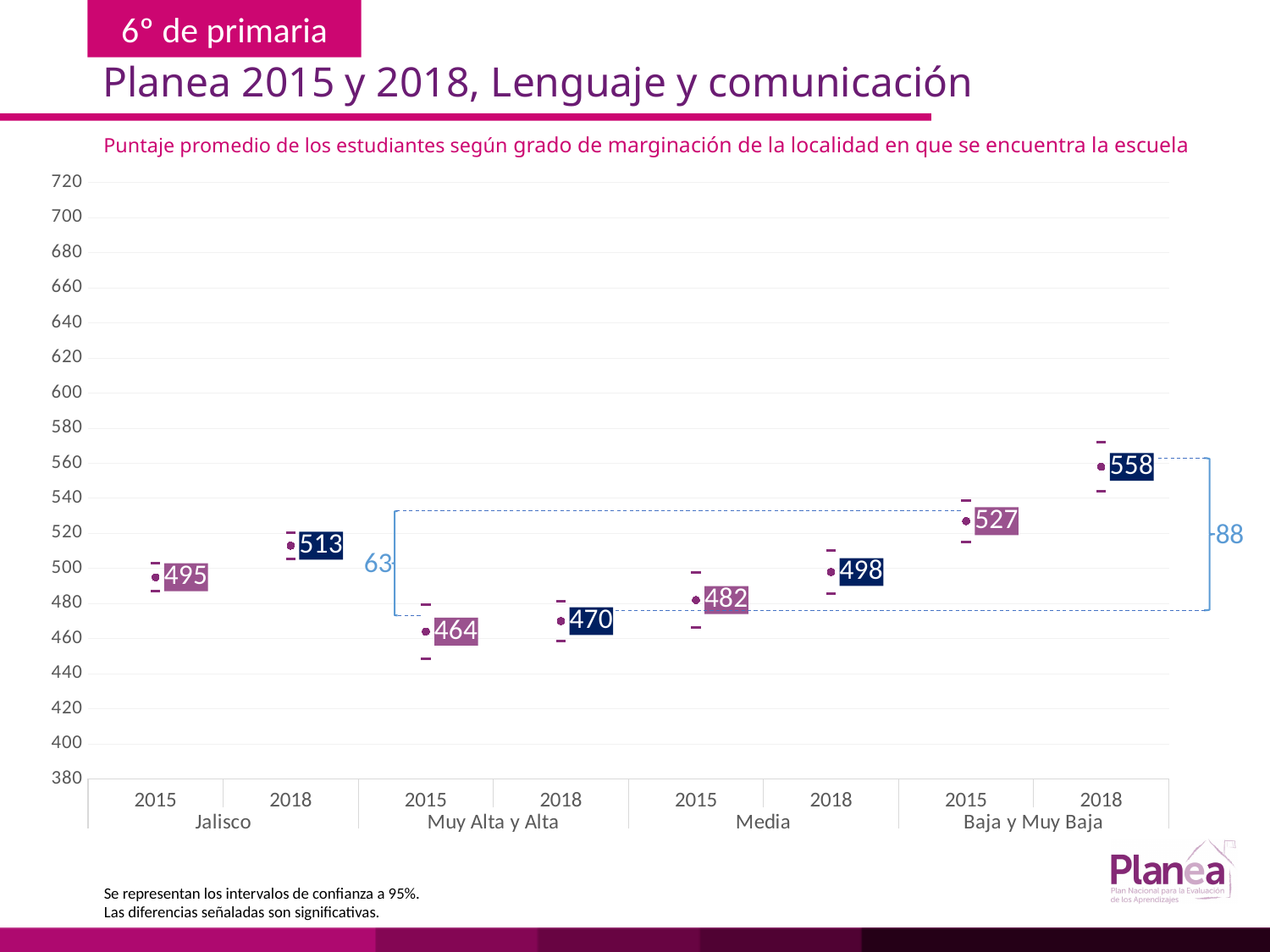
What is the difference between the 2018 and 2015 scores for the Media group? 16 Do the scores rise or fall from 2015 to 2018 within each marginación group? rise What is the average score for the Baja y Muy Baja marginación group in 2018? 558 Which group and year has the lowest average score? Muy Alta y Alta, 2015 How many data points are plotted on the chart? 8 What is the average score for Jalisco in 2018? 513 What is the average score for the Muy Alta y Alta marginación group in 2015? 464 What is the difference between the 2015 scores of the Baja y Muy Baja group and the Muy Alta y Alta group? 63 Which group and year has the highest average score? Baja y Muy Baja, 2018 What is the average score for Jalisco in 2015? 495 Is the 2018 score for Baja y Muy Baja greater or less than 540? greater Which is larger, the 2018 score for Media or the 2018 score for Jalisco? 2018 score for Jalisco